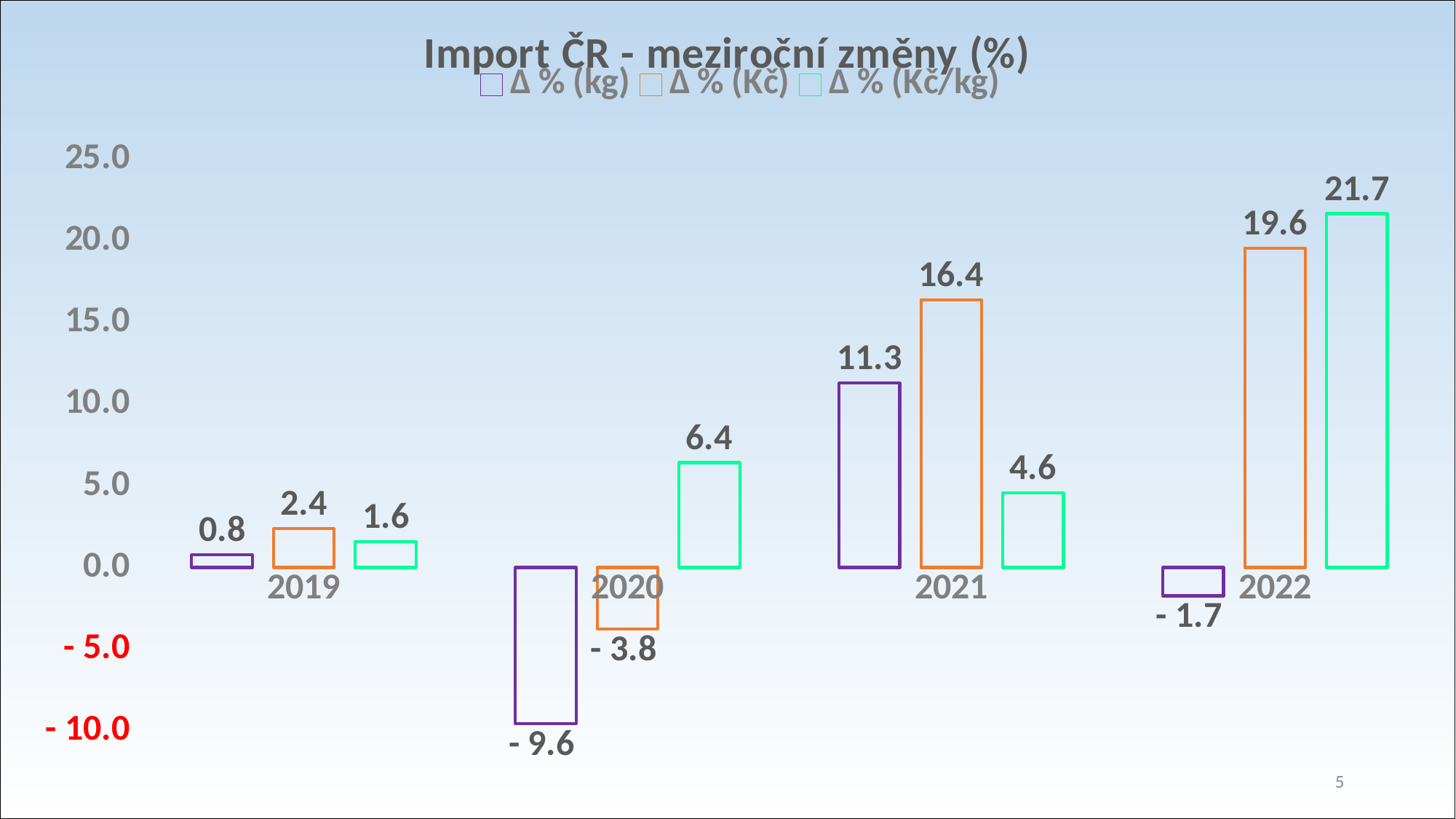
Does the Δ % (Kč/kg) series rise or fall from 2021 to 2022? rise Which is larger in 2020: the Δ % (Kč/kg) value or the Δ % (Kč) value? Δ % (Kč/kg) What kind of chart is shown on the slide? bar chart What is the Δ % (kg) value for 2022? - 1.7 What is the Δ % (kg) value for 2020? - 9.6 Which year has the lowest Δ % (kg) value? 2020 What is the difference between the Δ % (Kč) and Δ % (kg) values for 2021? 5.1 What is the Δ % (Kč/kg) value for 2022? 21.7 How many series does the legend list? 3 How many years are shown on the x axis? 4 Which year has the highest Δ % (Kč) value? 2022 What is the Δ % (Kč) value for 2021? 16.4